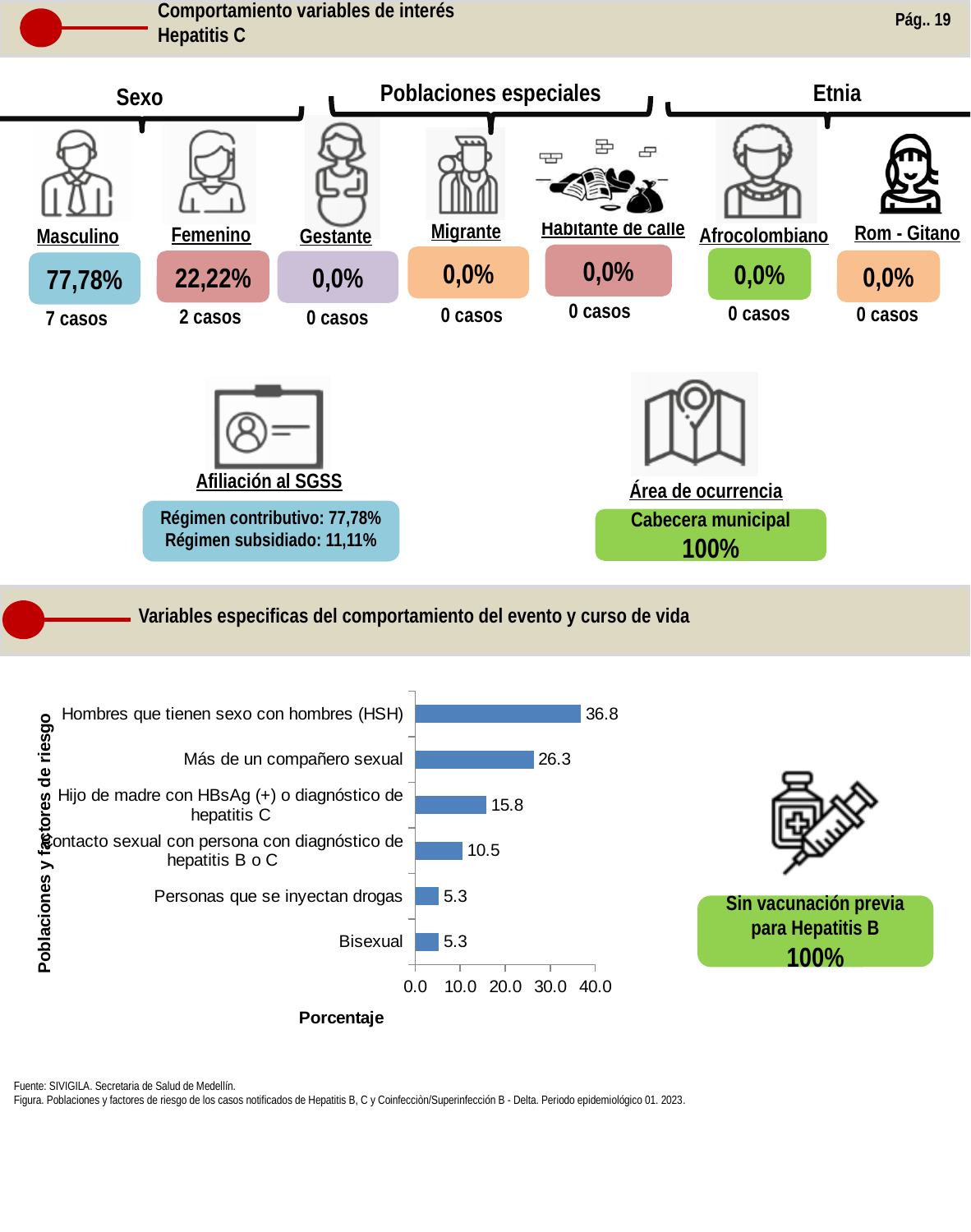
What is the value for Más de un compañero sexual in the bar chart? 26.3 Which category has the highest value in the bar chart? Hombres que tienen sexo con hombres (HSH) What is the difference between the values for Hombres que tienen sexo con hombres (HSH) and Más de un compañero sexual in the bar chart? 10.5 What is the label of the horizontal axis of the bar chart? Porcentaje What is the value for Contacto sexual con persona con diagnóstico de hepatitis B o C in the bar chart? 10.5 What is the value for Personas que se inyectan drogas in the bar chart? 5.3 What is the value for Hombres que tienen sexo con hombres (HSH) in the bar chart? 36.8 In the bar chart, which is larger: the value for Más de un compañero sexual or the value for Hijo de madre con HBsAg (+) o diagnóstico de hepatitis C? Más de un compañero sexual How many categories are shown in the bar chart? 6 Is the value for Hombres que tienen sexo con hombres (HSH) in the bar chart greater or less than 30.0? greater What kind of chart is shown at the bottom of the slide? Bar chart What is the difference between the values for Hijo de madre con HBsAg (+) o diagnóstico de hepatitis C and Bisexual in the bar chart? 10.5